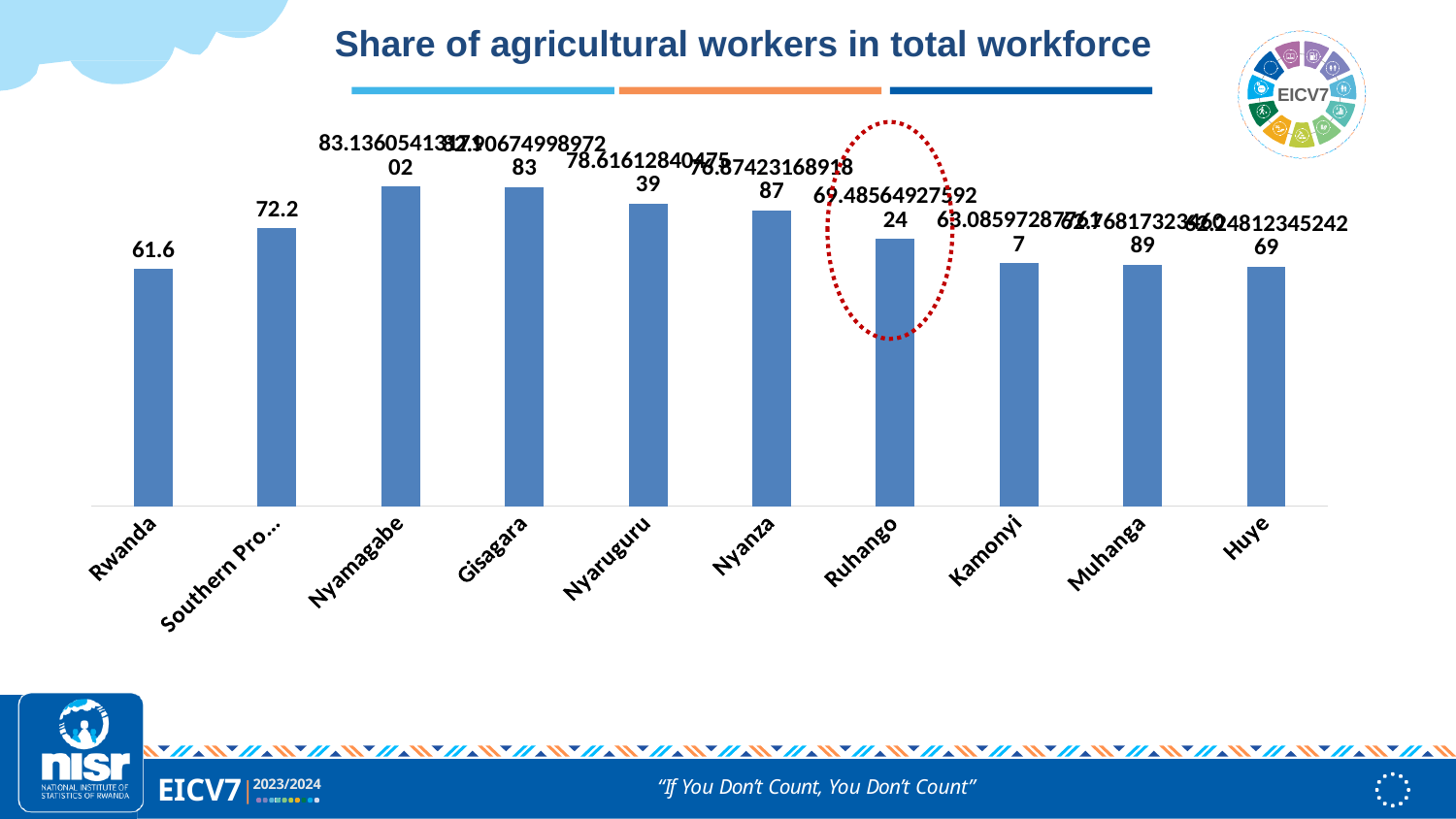
Which is larger, the value for Gisagara or the value for Kamonyi? Gisagara What is the value for Southern Pro…? 72.2 What is the value for Rwanda? 61.6 What is the title of the chart? Share of agricultural workers in total workforce What is the difference between the values for Southern Pro… and Rwanda? 10.6 What type of chart is shown on the slide? bar chart Which is larger, the value for Nyanza or the value for Ruhango? Nyanza Which is larger, the value for Nyamagabe or the value for Rwanda? Nyamagabe How many categories are shown on the x axis? 10 Which category's bar is highlighted with a red dotted circle? Ruhango